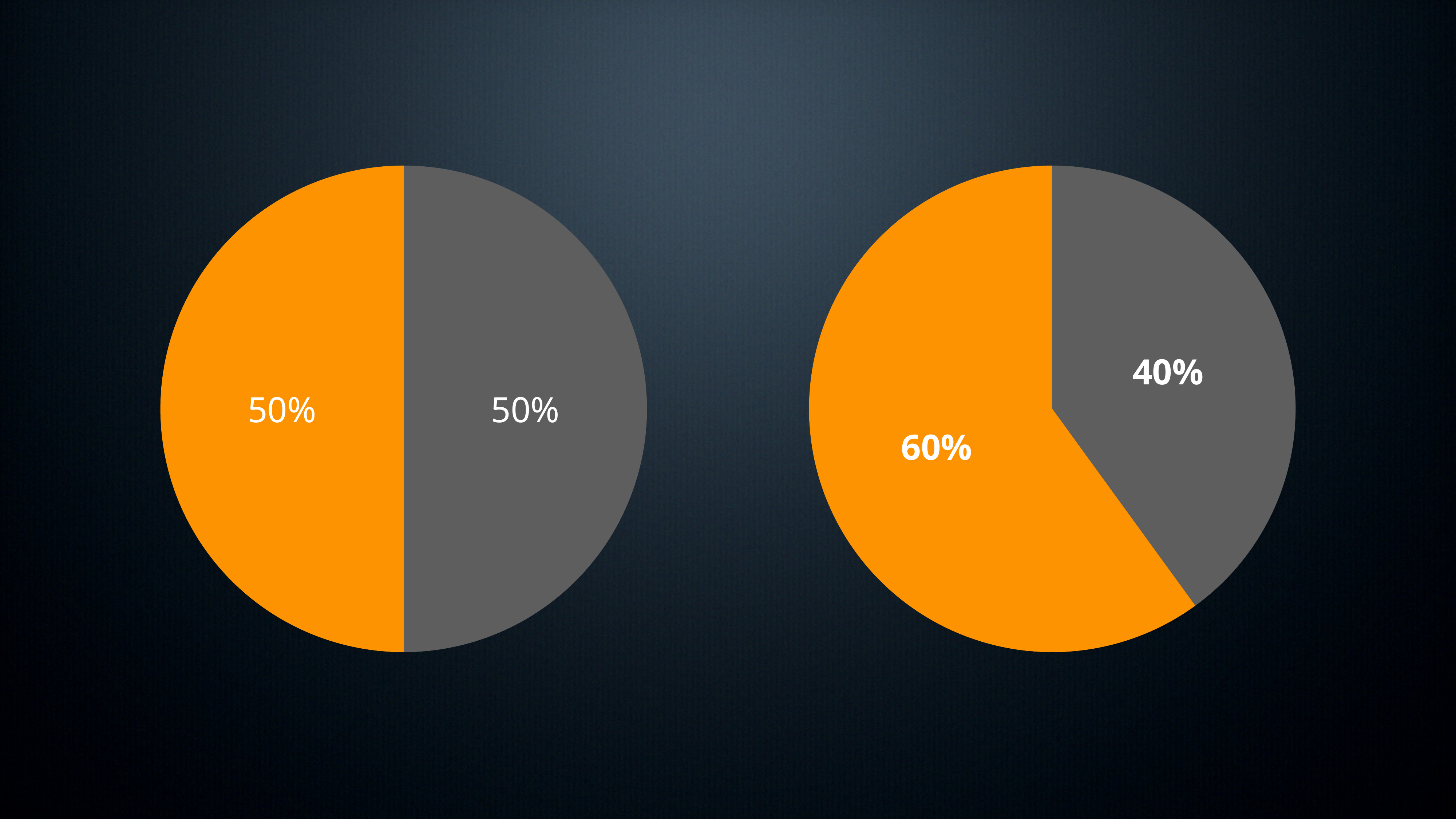
In the left pie chart, what value is labelled on the orange slice? 50% How many slices does the left pie chart have? 2 In the right pie chart, what value is labelled on the orange slice? 60% What kind of chart is shown on the left of the slide? pie chart In the right pie chart, which slice is larger, the orange one or the grey one? orange In the left pie chart, what value is labelled on the grey slice? 50% In the right pie chart, which slice is the smallest? grey In the right pie chart, what value is labelled on the grey slice? 40% What kind of chart is shown on the right of the slide? pie chart How many pie charts are shown on the slide? 2 How many slices does the right pie chart have? 2 In the right pie chart, what is the difference between the orange slice and the grey slice? 20%